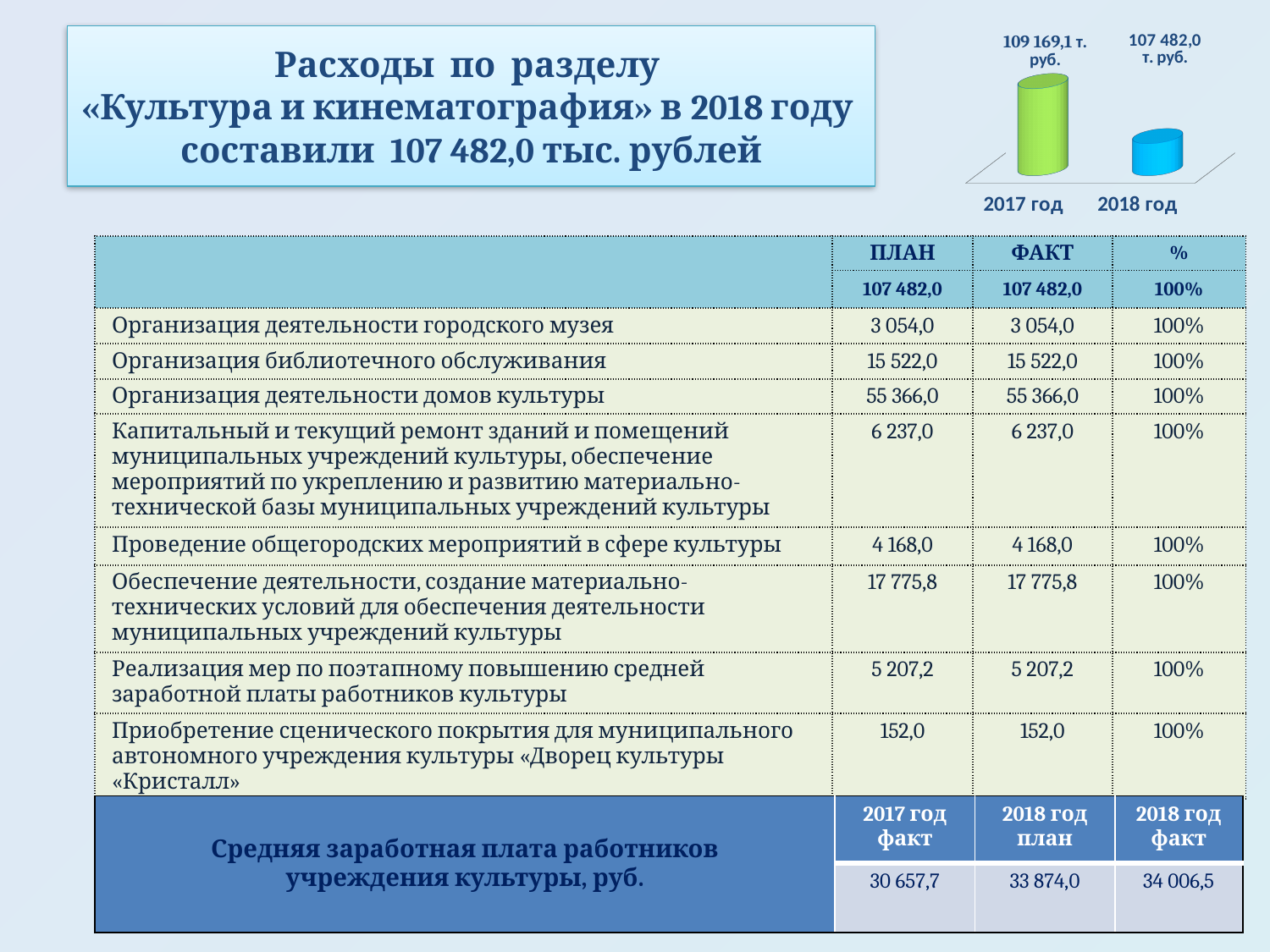
How many bars are plotted in the bar chart? 2 What colour is the bar for 2018 год in the bar chart? blue What is the value shown for 2018 год in the bar chart? 107 482,0 т. руб. What is the value shown for 2017 год in the bar chart? 109 169,1 т. руб. What type of chart is shown in the top right of the slide? bar chart By how much does the 2017 год value exceed the 2018 год value in the bar chart? 1 687,1 т. руб. Is the value for 2018 год larger or smaller than the value for 2017 год in the bar chart? smaller Which year has the higher value in the bar chart? 2017 год Which year has the lower value in the bar chart? 2018 год What colour is the bar for 2017 год in the bar chart? green Do the values in the bar chart rise or fall from 2017 год to 2018 год? fall